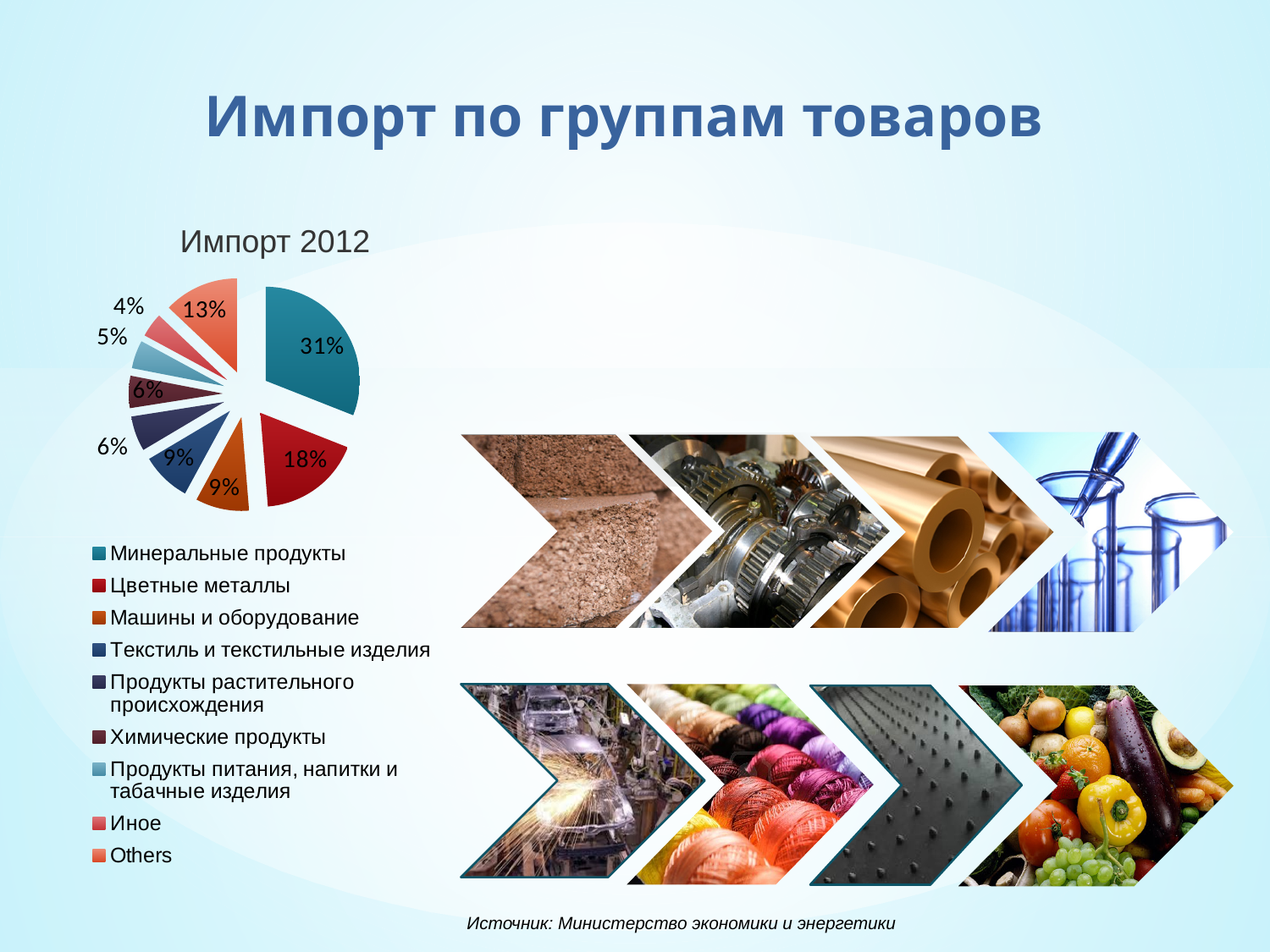
What is the difference between the shares of Минеральные продукты and Цветные металлы? 13% Which category has the largest share of the pie? Минеральные продукты What is the value for Иное? 4% Which category has the smallest share of the pie? Иное What is the title of the pie chart? Импорт 2012 What is the value for Продукты питания, напитки и табачные изделия? 5% What share of the pie does Минеральные продукты have? 31% Which is larger, the share of Others or the share of Машины и оборудование? Others What is the value for Цветные металлы? 18% How many categories does the legend list? 9 What kind of chart is shown on the slide? pie chart What is the value for Others? 13%